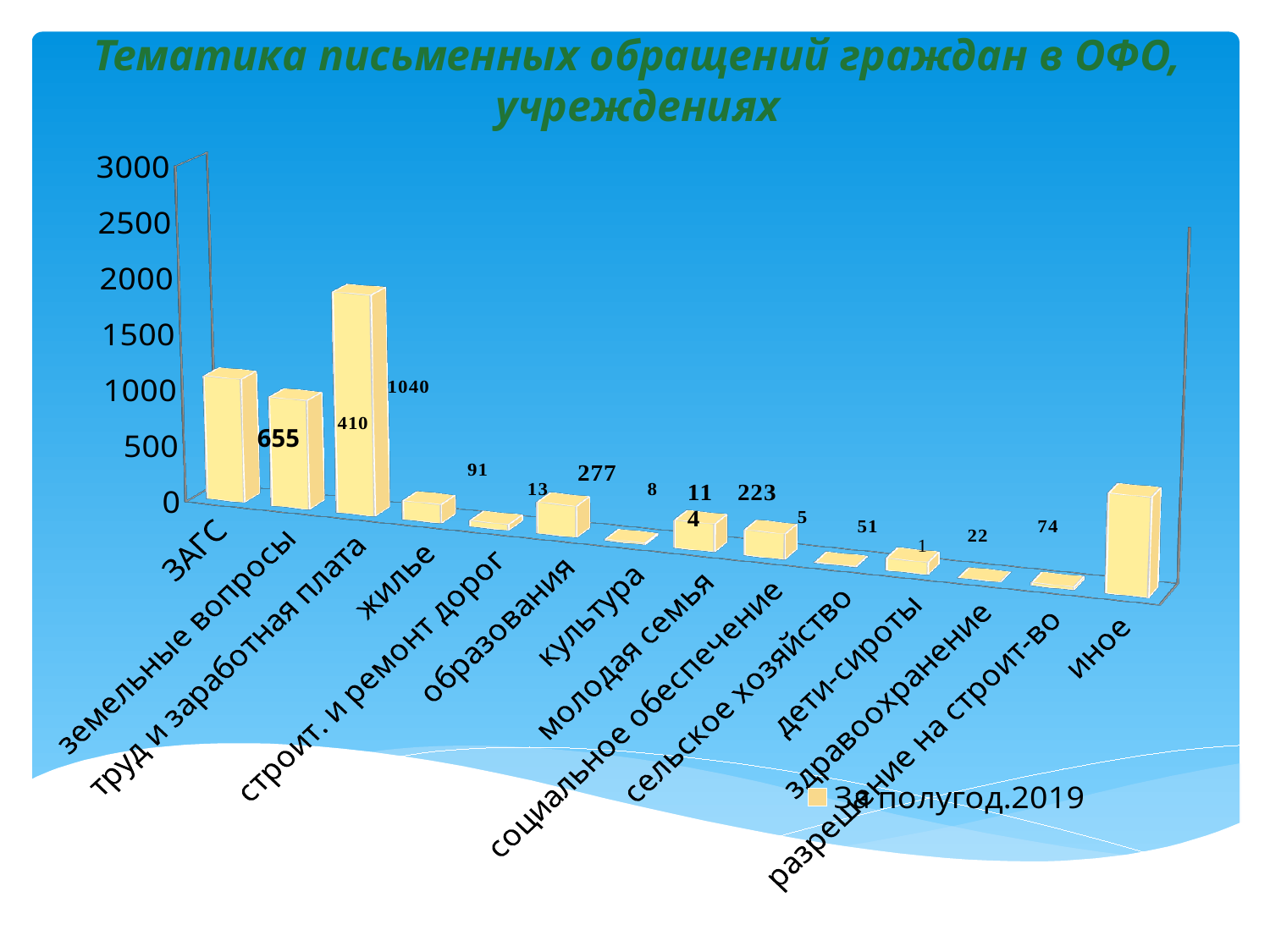
Which category has the highest bar? труд и заработная плата Is the value for труд и заработная плата greater or less than 1500? greater Is the value for ЗАГС greater or less than 500? greater Which is larger, the value for ЗАГС or the value for иное? ЗАГС What is the legend entry for the series? За полугод.2019 Is the value for иное greater or less than 1000? less What kind of chart is shown on the slide? bar chart How many categories are shown along the x axis? 14 Which is larger, the value for труд и заработная плата or the value for ЗАГС? труд и заработная плата What is the title of the chart? Тематика письменных обращений граждан в ОФО, учреждениях How many series does the legend list? 1